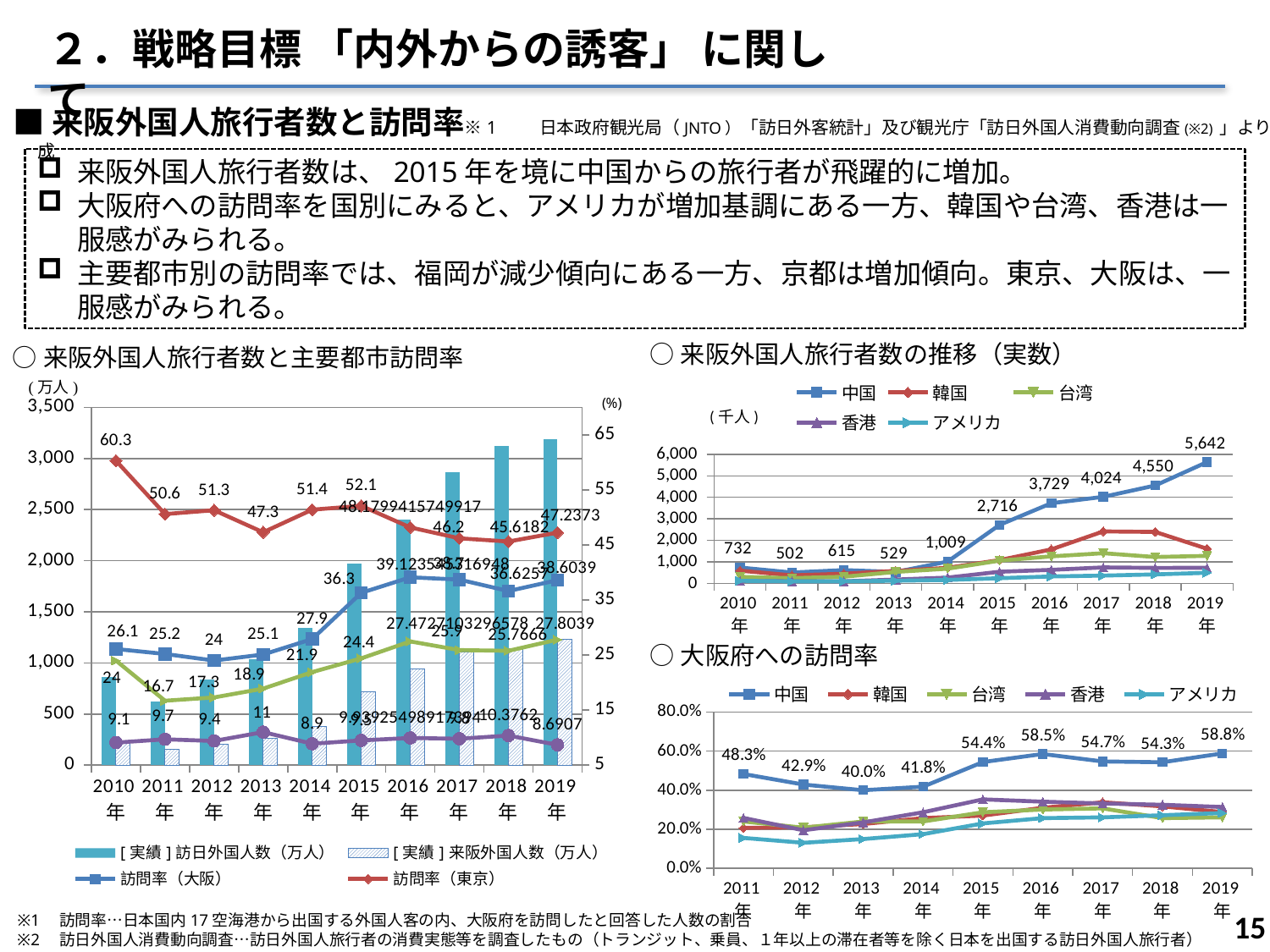
In the chart titled 大阪府への訪問率, what is the value for 中国 in 2019年? 58.8% What kind of chart is the chart titled 来阪外国人旅行者数の推移（実数）? Line chart In the chart titled 来阪外国人旅行者数の推移（実数）, how many series does the legend list? 5 In the chart titled 大阪府への訪問率, how many years are shown on the x axis? 9 In the chart titled 来阪外国人旅行者数と主要都市訪問率, what is the 訪問率（大阪） value in 2015年? 36.3 In the chart titled 来阪外国人旅行者数の推移（実数）, by how much did the 中国 value increase from 2018年 to 2019年? 1,092 In the chart titled 来阪外国人旅行者数の推移（実数）, what is the value for 中国 in 2019年? 5,642 In the chart titled 大阪府への訪問率, is the value for アメリカ in 2012年 greater or less than 20.0%? less In the chart titled 来阪外国人旅行者数の推移（実数）, what is the value for 中国 in 2015年? 2,716 In the chart titled 大阪府への訪問率, in which year is the 中国 value lowest? 2013年 In the chart titled 来阪外国人旅行者数と主要都市訪問率, what is the 訪問率（東京） value in 2010年? 60.3 In the chart titled 来阪外国人旅行者数と主要都市訪問率, which is larger in 2010年: 訪問率（東京） or 訪問率（大阪）? 訪問率（東京）